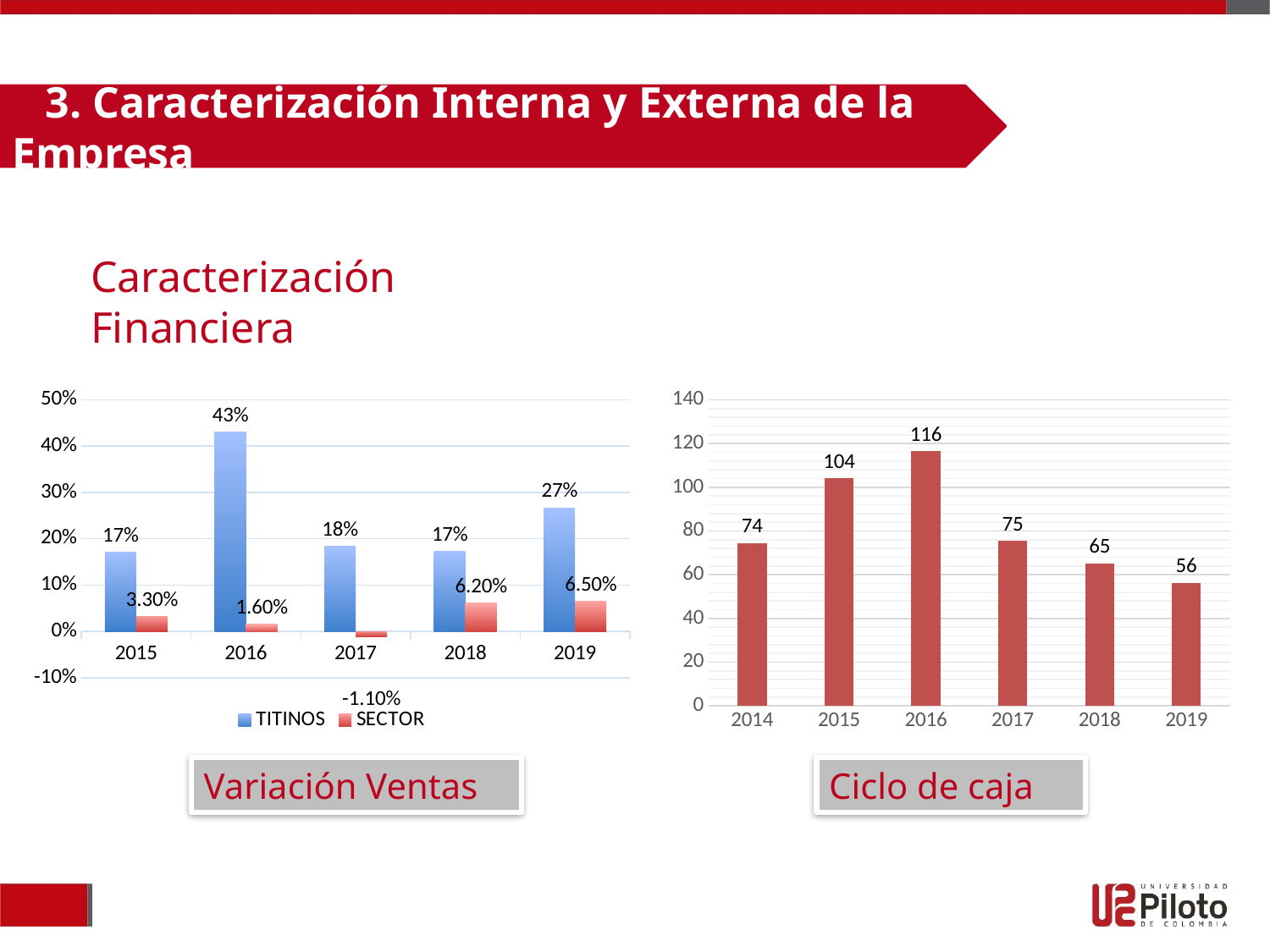
In the Variación Ventas chart, what is the TITINOS value for 2016? 43% In the Ciclo de caja chart, what is the difference between the 2016 value and the 2019 value? 60 In the Ciclo de caja chart, what is the value for 2015? 104 In the Variación Ventas chart, which is larger in 2018: the TITINOS value or the SECTOR value? TITINOS In the Variación Ventas chart, how many series does the legend list? 2 In the Variación Ventas chart, which year has the lowest SECTOR value? 2017 In the Variación Ventas chart, which year has the highest TITINOS value? 2016 In the Ciclo de caja chart, how many years are shown on the x axis? 6 In the Variación Ventas chart, what is the difference between the TITINOS value and the SECTOR value in 2019? 20.50% In the Ciclo de caja chart, which year has the highest value? 2016 In the Variación Ventas chart, what is the SECTOR value for 2017? -1.10% In the Ciclo de caja chart, which year has the lowest value? 2019